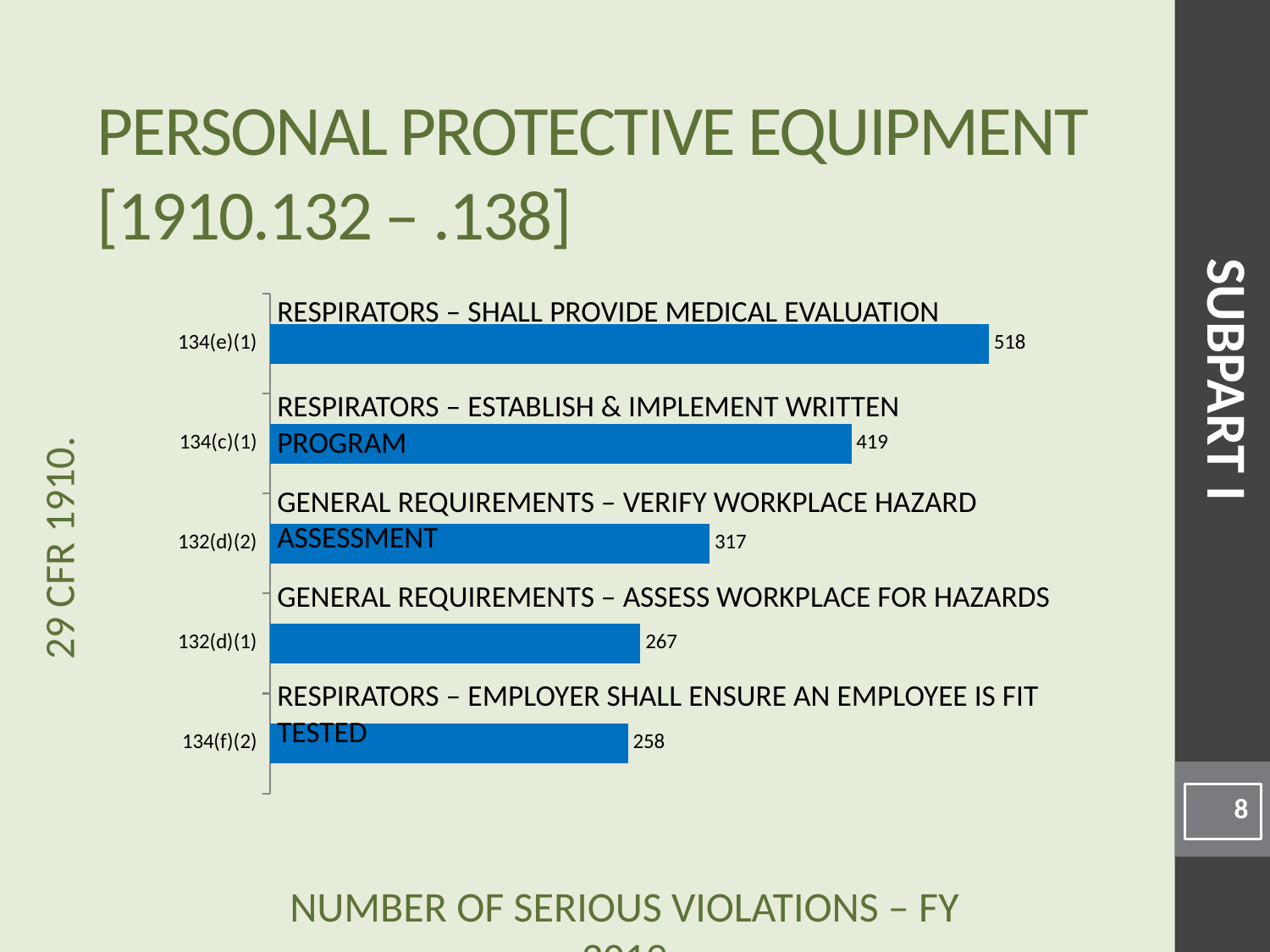
What is the difference between the violations for 134(e)(1) and 134(c)(1)? 99 What is the number of serious violations for 132(d)(2)? 317 What is the difference between the violations for 132(d)(2) and 132(d)(1)? 50 What is the number of serious violations for 134(f)(2)? 258 What is the number of serious violations for 134(e)(1)? 518 What kind of chart is shown on the slide? Bar chart Which standard has the lowest number of serious violations? 134(f)(2) How many standards are shown in the chart? 5 What colour are the bars in the chart? Blue Which has more serious violations, 134(c)(1) or 132(d)(1)? 134(c)(1) What is the value for the bar labelled 'RESPIRATORS – ESTABLISH & IMPLEMENT WRITTEN PROGRAM'? 419 Which standard has the highest number of serious violations? 134(e)(1)